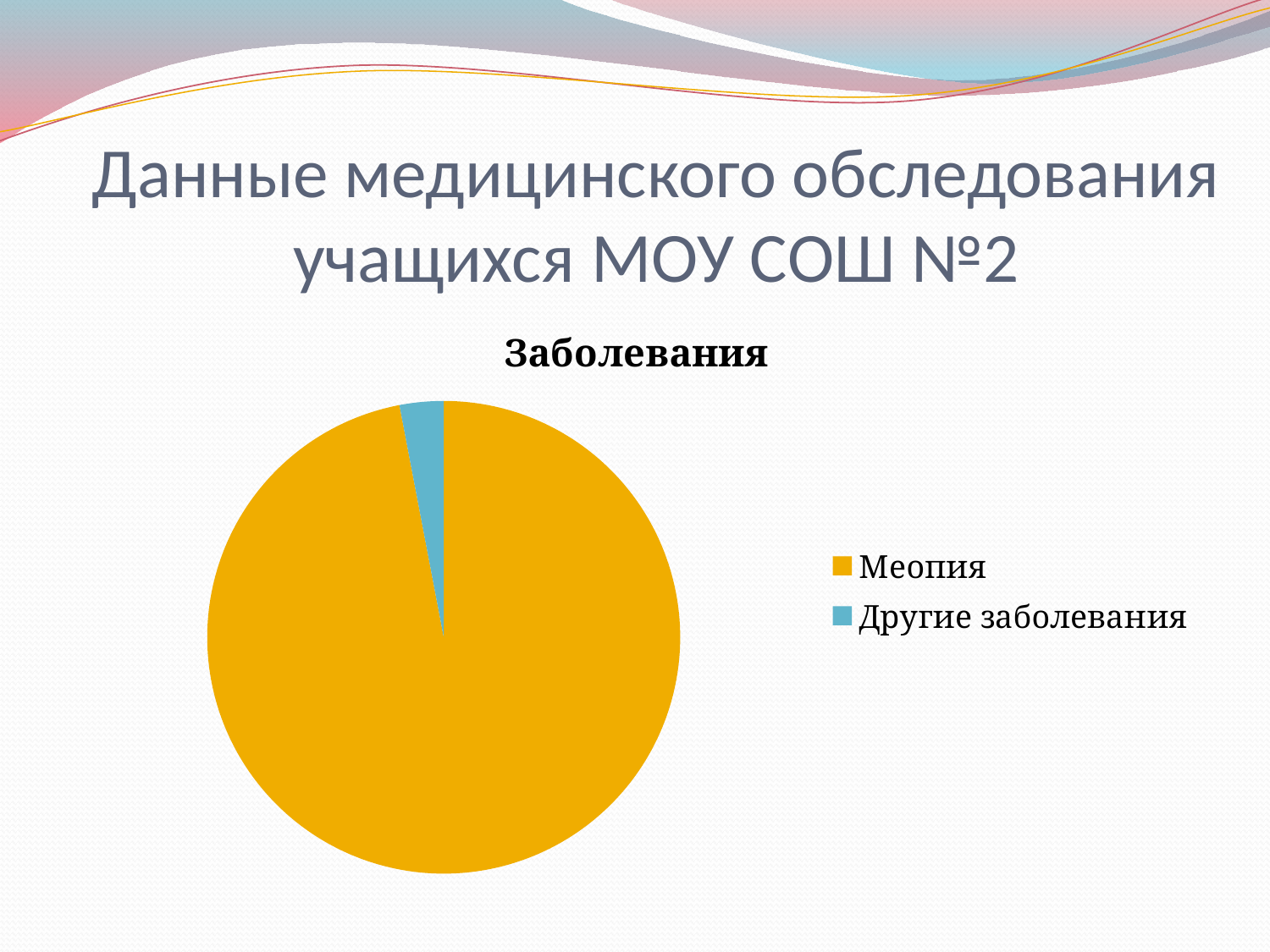
What colour is the slice for Другие заболевания? blue What kind of chart is shown on the slide? pie chart How many entries does the legend list? 2 Which is larger, the slice for Меопия or the slice for Другие заболевания? Меопия How many slices does the pie chart have? 2 Which category has the largest slice of the pie? Меопия What is the title of the chart? Заболевания Which category has the smallest slice of the pie? Другие заболевания